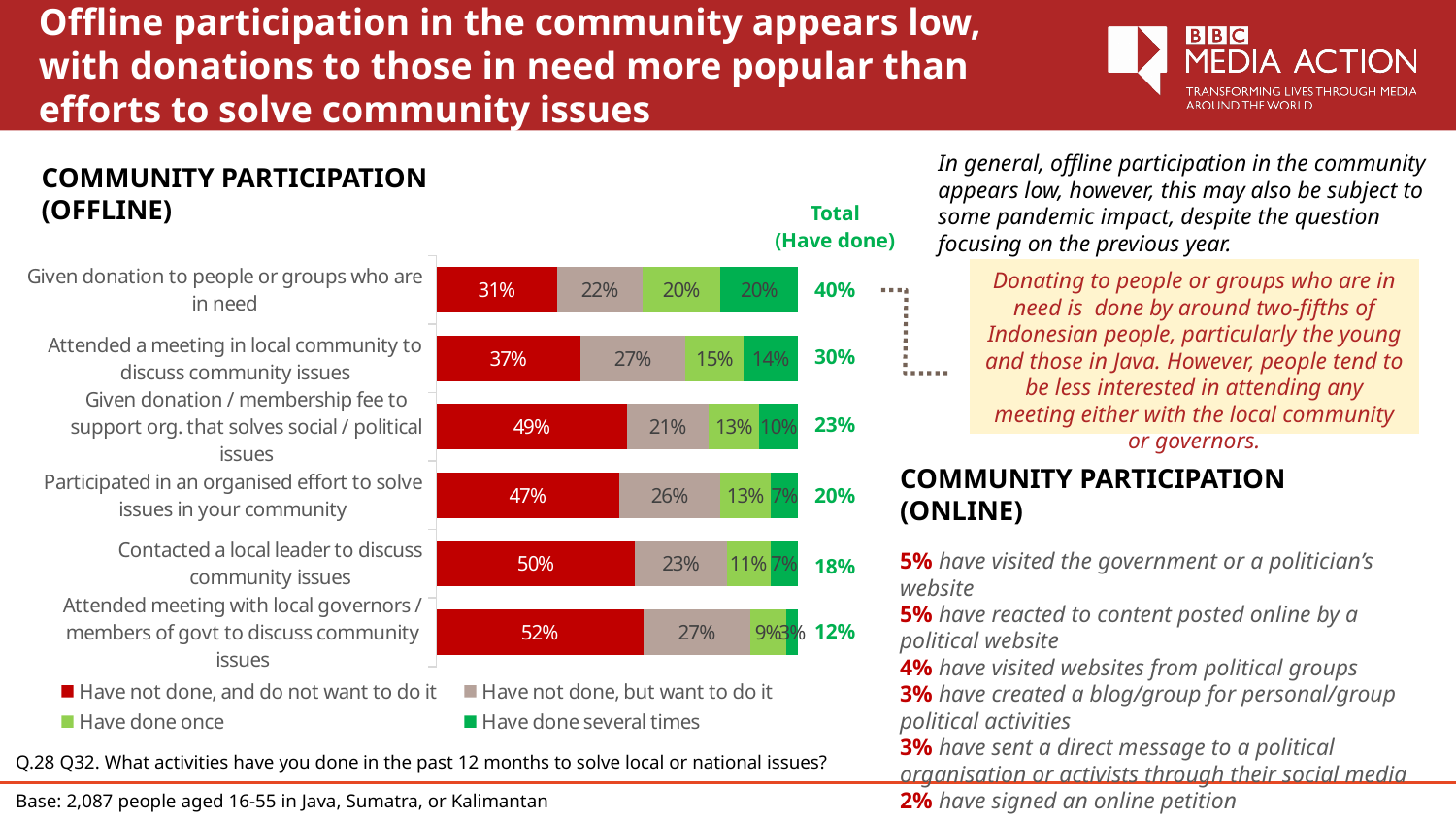
In the COMMUNITY PARTICIPATION (OFFLINE) chart, which colour represents 'Have not done, but want to do it'? Grey In the COMMUNITY PARTICIPATION (OFFLINE) chart, which has a larger 'Have not done, and do not want to do it' share: 'Contacted a local leader to discuss community issues' or 'Participated in an organised effort to solve issues in your community'? Contacted a local leader to discuss community issues Which activity in the COMMUNITY PARTICIPATION (OFFLINE) chart has the lowest Total (Have done)? Attended meeting with local governors / members of govt to discuss community issues In the COMMUNITY PARTICIPATION (OFFLINE) chart, what is the 'Have done several times' value for 'Attended a meeting in local community to discuss community issues'? 14% In the COMMUNITY PARTICIPATION (OFFLINE) chart, what is the Total (Have done) for 'Contacted a local leader to discuss community issues'? 18% How many series does the legend of the COMMUNITY PARTICIPATION (OFFLINE) chart list? 4 In the COMMUNITY PARTICIPATION (OFFLINE) chart, what is the combined 'Have not done' share (do not want plus want to do it) for 'Given donation / membership fee to support org. that solves social / political issues'? 70% In the COMMUNITY PARTICIPATION (OFFLINE) chart, what is the difference between the Total (Have done) for 'Given donation to people or groups who are in need' and for 'Attended a meeting in local community to discuss community issues'? 10 percentage points What kind of chart is shown under the heading COMMUNITY PARTICIPATION (OFFLINE)? Stacked bar chart How many categories (activities) are shown in the COMMUNITY PARTICIPATION (OFFLINE) chart? 6 In the COMMUNITY PARTICIPATION (OFFLINE) chart, what percentage 'Have not done, and do not want to do it' for 'Given donation to people or groups who are in need'? 31% Which activity in the COMMUNITY PARTICIPATION (OFFLINE) chart has the highest Total (Have done)? Given donation to people or groups who are in need